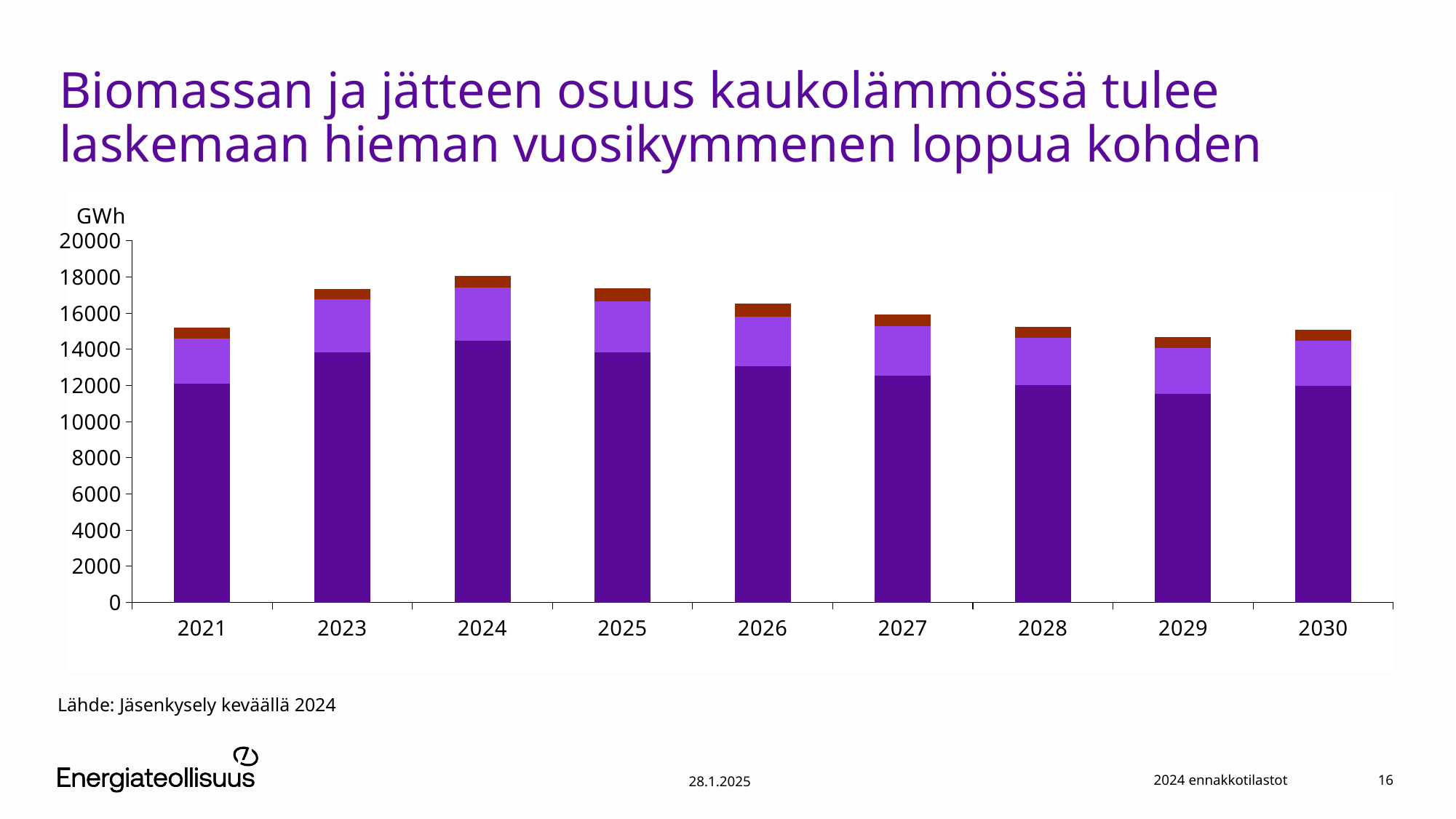
Is the total bar for 2024 greater or less than 16000? greater How many years are shown on the x axis of the chart? 9 Is the total bar for 2029 greater or less than 14000? greater What kind of chart is shown on the slide? stacked bar chart From 2024 to 2030, do the total bar heights generally rise or fall? fall What unit is shown on the y axis of the chart? GWh Is the total bar for 2021 greater or less than 16000? less Which year has the highest total bar in the chart? 2024 Which total bar is taller, 2023 or 2026? 2023 Which total bar is taller, 2021 or 2024? 2024